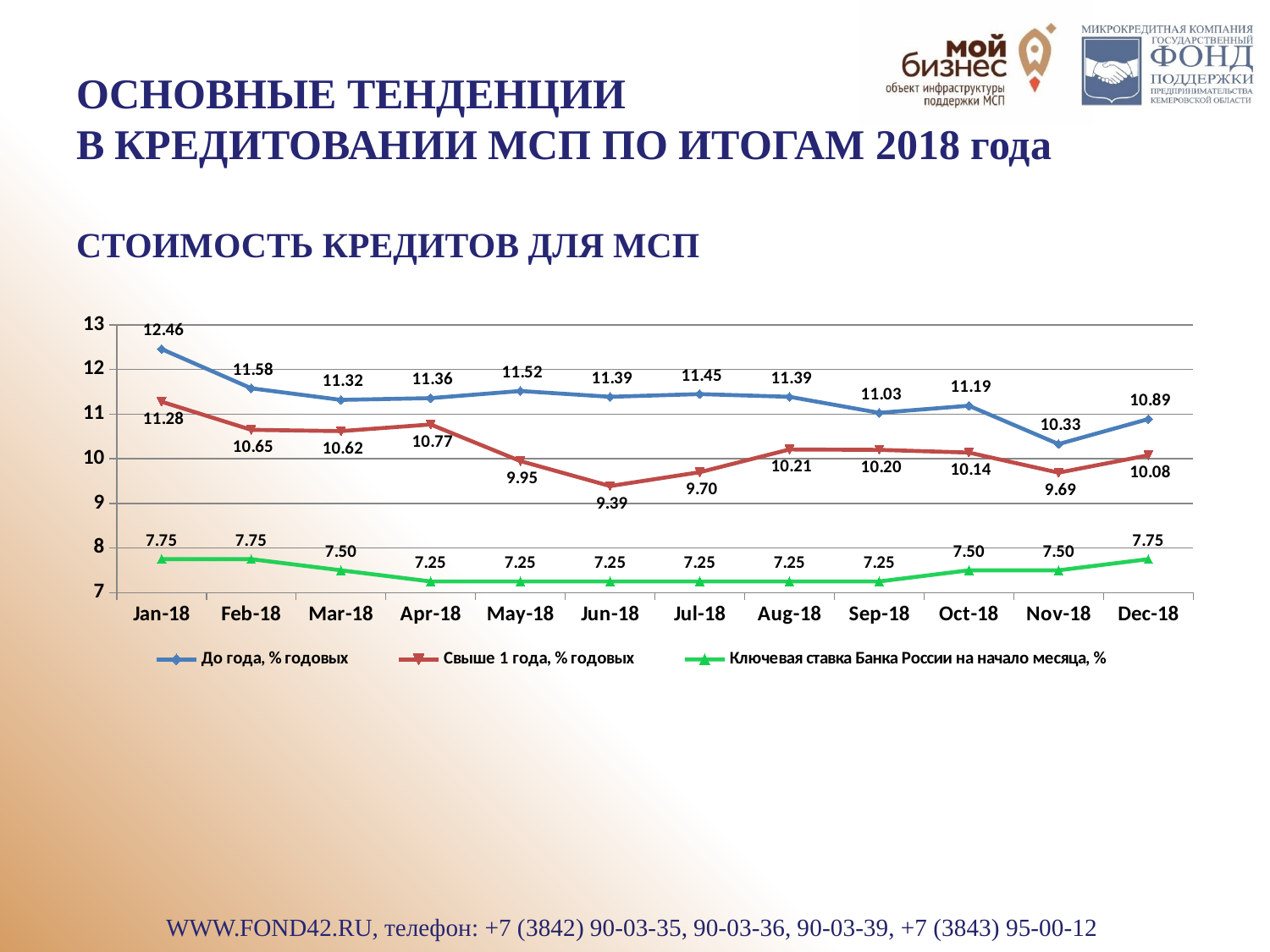
In which month is the 'Свыше 1 года, % годовых' series at its highest? Jan-18 How many series does the legend list? 3 In which month is the 'До года, % годовых' series at its lowest? Nov-18 What is the value of the 'Свыше 1 года, % годовых' series for Jun-18? 9.39 What is the difference between the 'До года, % годовых' value and the 'Свыше 1 года, % годовых' value in Dec-18? 0.81 What is the value of the 'До года, % годовых' series for Jan-18? 12.46 Does the 'До года, % годовых' series overall rise or fall from Jan-18 to Dec-18? Fall Which is larger in Sep-18: the 'До года, % годовых' value or the 'Свыше 1 года, % годовых' value? До года, % годовых What type of chart is shown on the slide? Line chart What is the value of 'Ключевая ставка Банка России на начало месяца, %' for Oct-18? 7.50 What is the title of the chart? СТОИМОСТЬ КРЕДИТОВ ДЛЯ МСП How many months are plotted along the x axis? 12